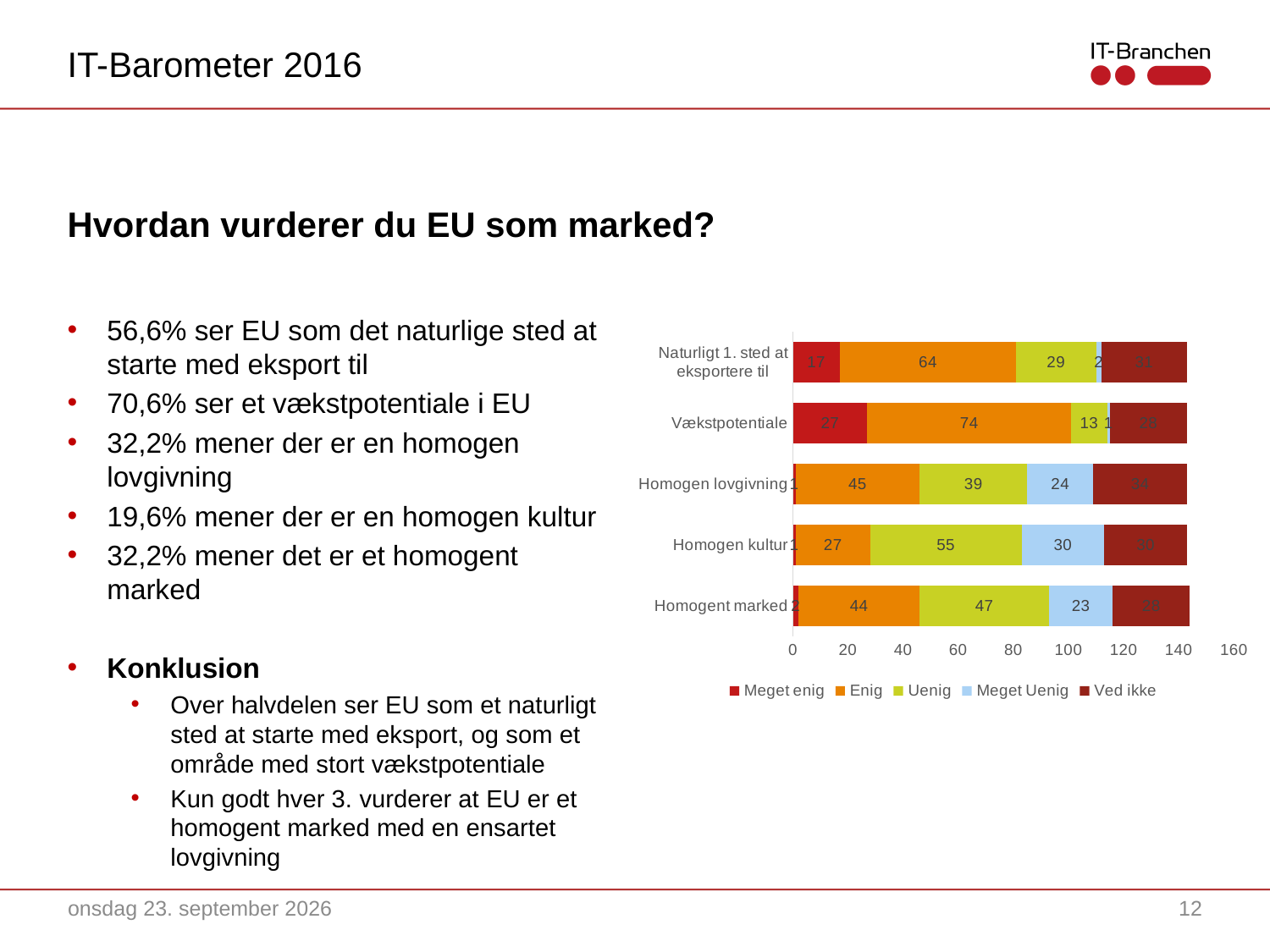
Which category has the highest 'Enig' value? Vækstpotentiale What is the first entry in the chart's legend? Meget enig How many series does the legend of the chart list? 5 Which category has the lowest 'Meget Uenig' value? Vækstpotentiale What is the difference between the 'Uenig' values for 'Homogen kultur' and 'Homogen lovgivning'? 16 How many categories are shown on the chart's vertical axis? 5 Which has the larger 'Meget enig' value: 'Vækstpotentiale' or 'Naturligt 1. sted at eksportere til'? Vækstpotentiale What kind of chart is shown on the slide? bar chart What is the 'Meget Uenig' value for 'Homogen lovgivning'? 24 Is the total length of the stacked bar for 'Vækstpotentiale' greater or less than 120? greater What is the 'Uenig' value for 'Homogen kultur'? 55 What is the 'Enig' value for 'Vækstpotentiale'? 74